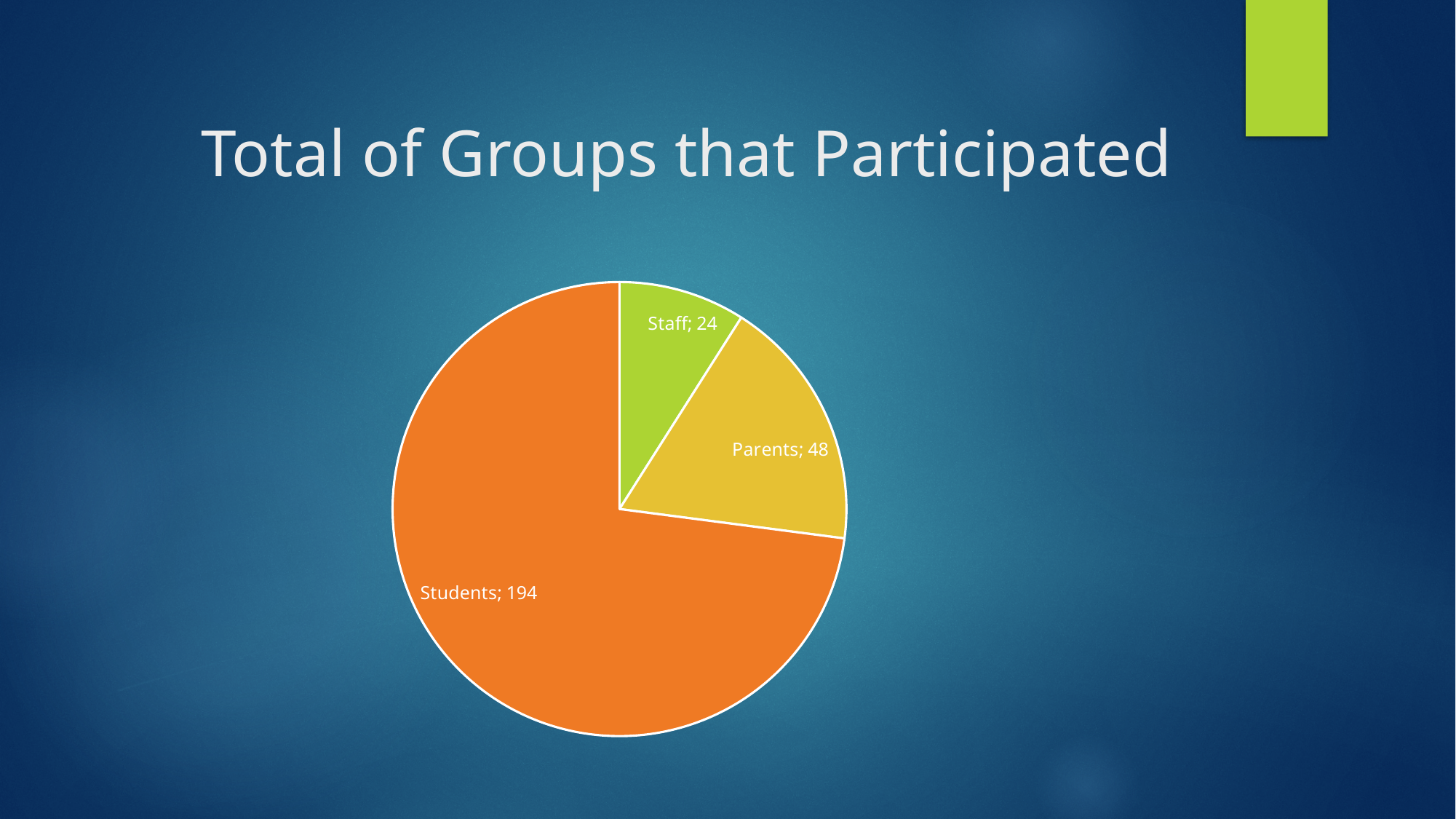
Which group has the largest slice of the pie chart? Students What is the value for Students in the pie chart? 194 Which group has the smallest slice of the pie chart? Staff What is the value for Staff in the pie chart? 24 What is the difference between the Parents value and the Staff value? 24 What kind of chart is shown on the slide? Pie chart What is the value for Parents in the pie chart? 48 What is the total of all three slices in the pie chart? 266 How many groups are shown in the pie chart? 3 What is the title of the slide containing the pie chart? Total of Groups that Participated Which is larger, the value for Parents or the value for Staff? Parents What is the difference between the Students value and the Parents value? 146